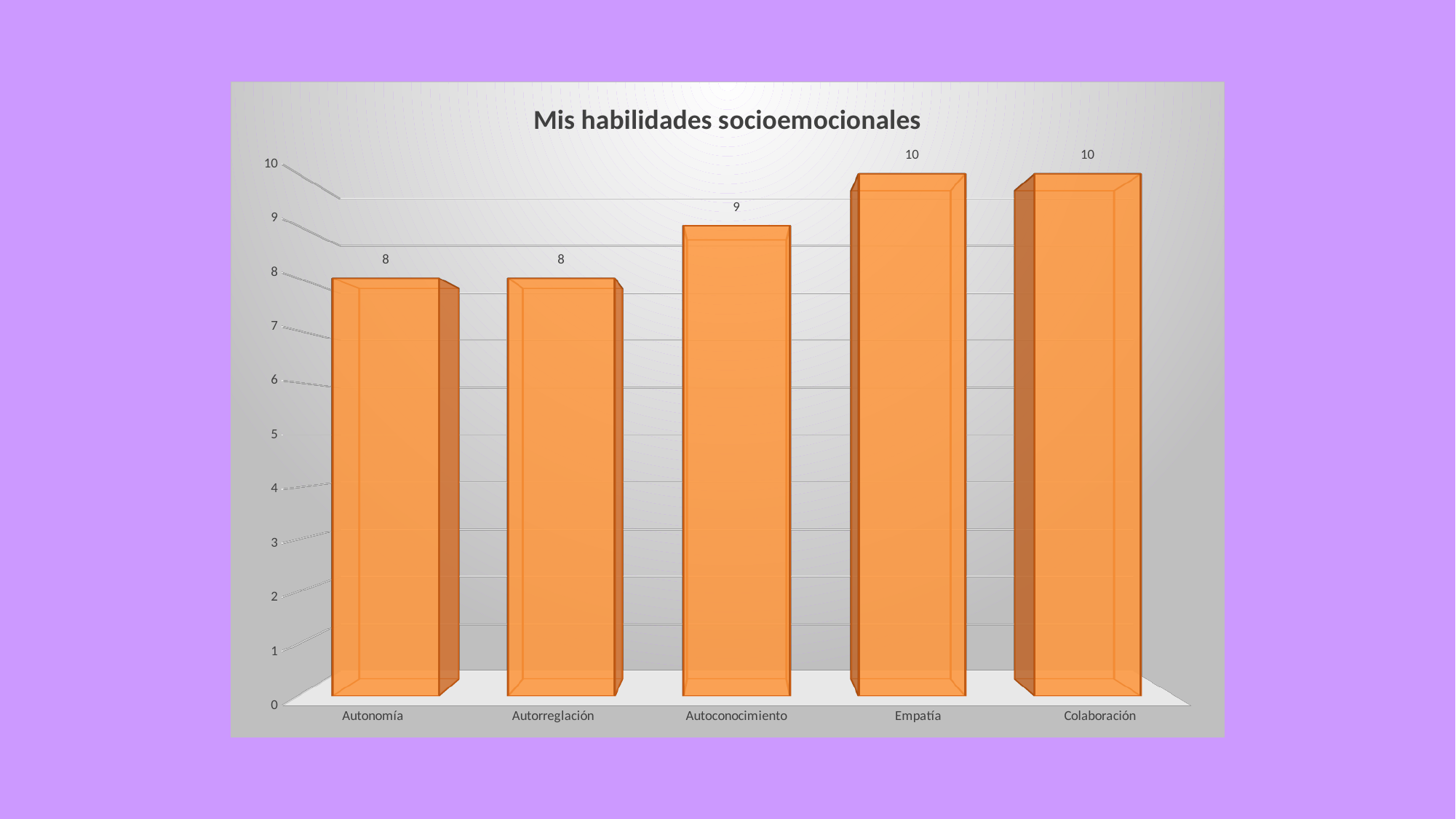
What is the value for Autonomía? 8 What kind of chart is shown on the slide? Bar chart What is the value for Autorreglación? 8 What is the value for Autoconocimiento? 9 Do the values rise or fall from Autonomía to Empatía along the x axis? Rise Which categories have the highest value? Empatía and Colaboración Which categories have the lowest value? Autonomía and Autorreglación Which is larger, the value for Autoconocimiento or the value for Autorreglación? Autoconocimiento How many categories are shown on the x axis? 5 What is the title of the chart? Mis habilidades socioemocionales What is the value for Empatía? 10 What is the difference between the values for Colaboración and Autonomía? 2